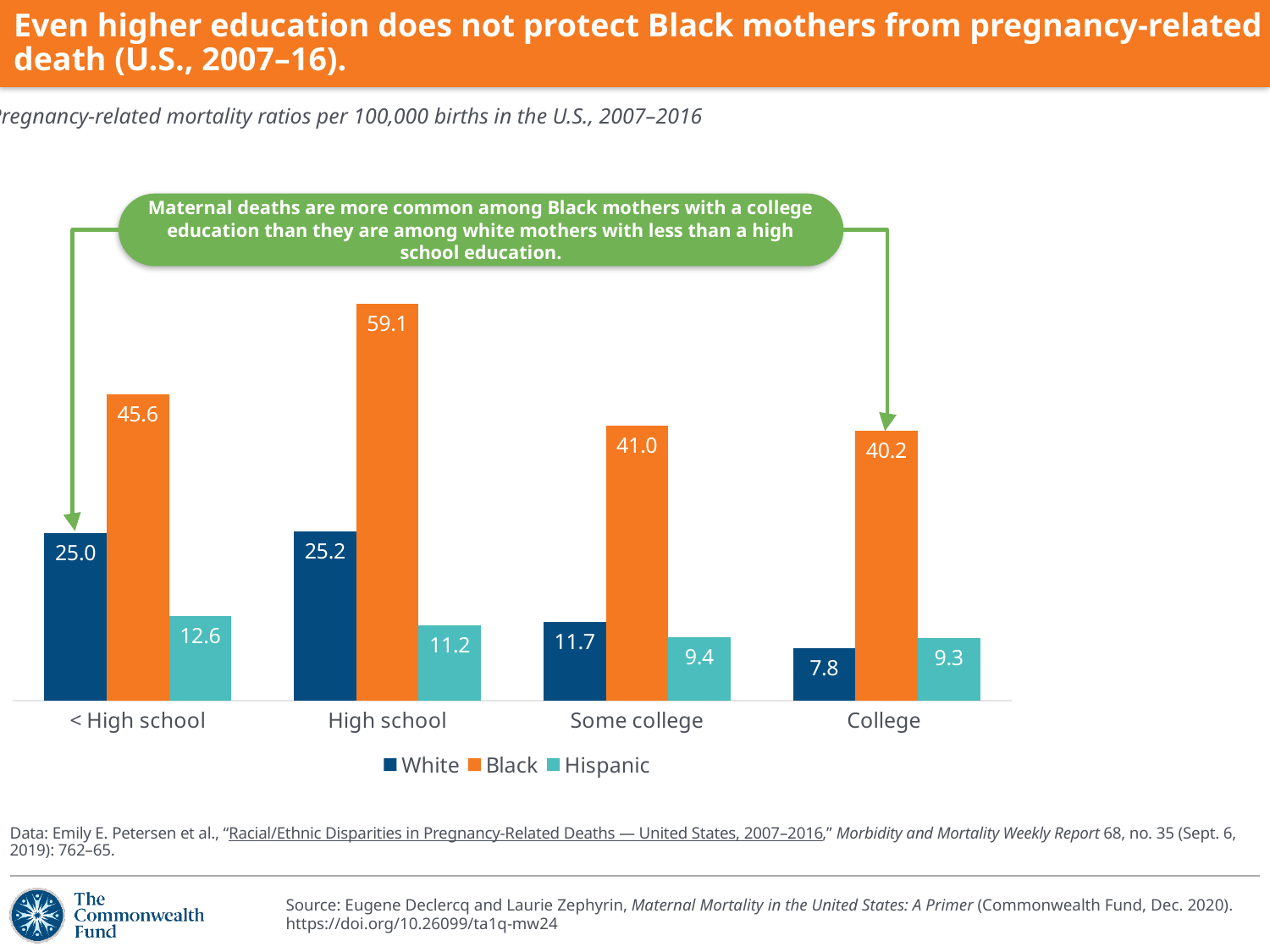
Which is larger: the Black value for College or the White value for < High school? Black value for College What is the pregnancy-related mortality ratio for Black mothers with a high school education? 59.1 What kind of chart is shown on the slide? Bar chart What is the value for Hispanic mothers in the < High school category? 12.6 Which education category has the lowest value for Hispanic mothers? College What is the difference between the Black and White values in the College category? 32.4 Which education category has the highest value for Black mothers? High school What is the value for White mothers in the College category? 7.8 How many series does the legend list? 3 Do the values for White mothers rise or fall from < High school to College? Fall How many education categories are shown on the x axis? 4 Which colour represents the Black series in the chart? Orange